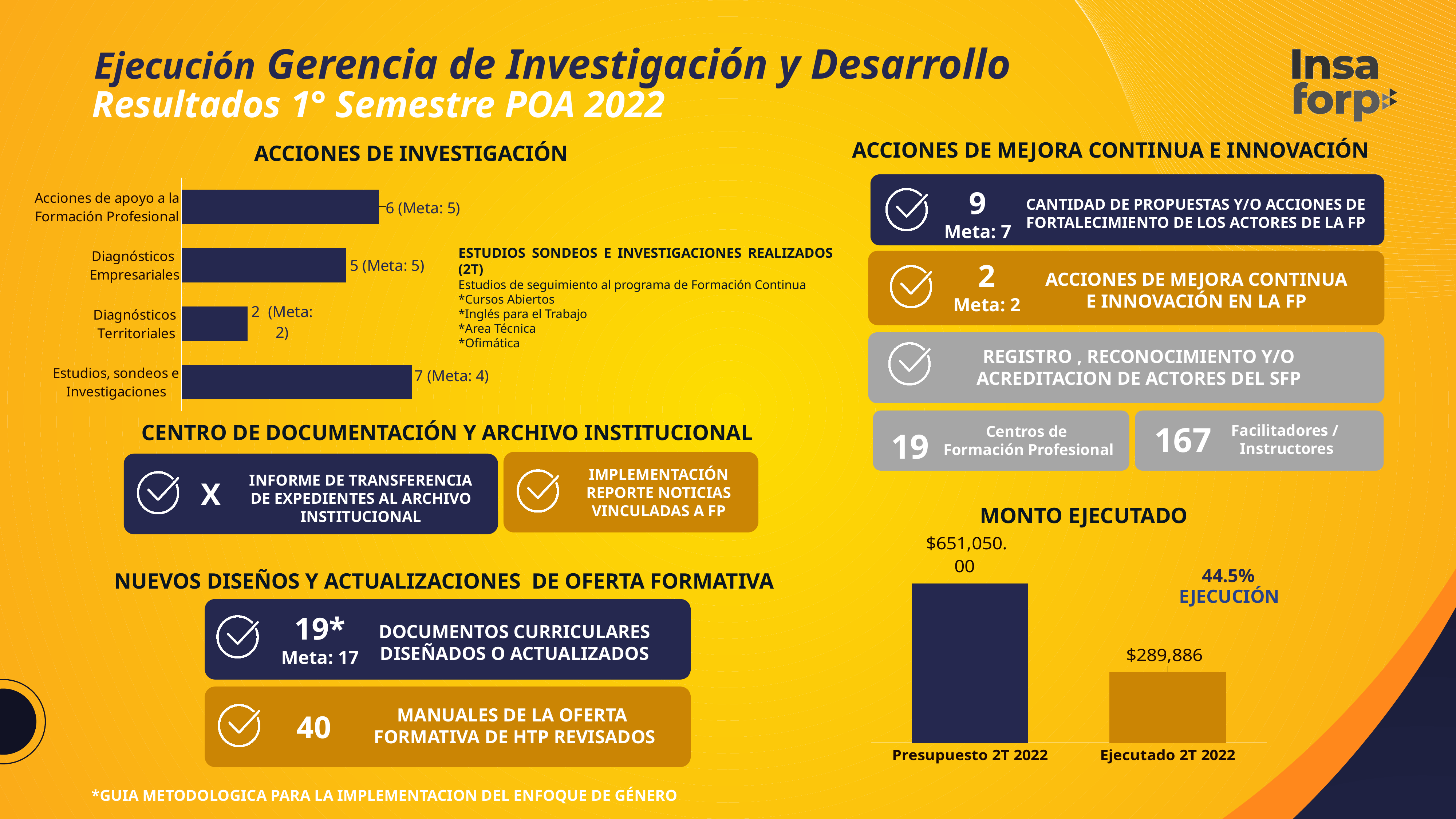
In the 'MONTO EJECUTADO' chart, what is the value for Ejecutado 2T 2022? $289,886 How many categories does the 'ACCIONES DE INVESTIGACIÓN' chart show? 4 In the 'MONTO EJECUTADO' chart, which bar is higher: Presupuesto 2T 2022 or Ejecutado 2T 2022? Presupuesto 2T 2022 What kind of chart is 'ACCIONES DE INVESTIGACIÓN'? Bar chart In the 'MONTO EJECUTADO' chart, what is the value for Presupuesto 2T 2022? $651,050.00 In the 'ACCIONES DE INVESTIGACIÓN' chart, which category has the lowest value? Diagnósticos Territoriales In the 'ACCIONES DE INVESTIGACIÓN' chart, what is the difference between the values for Estudios, sondeos e Investigaciones and Diagnósticos Territoriales? 5 In the 'ACCIONES DE INVESTIGACIÓN' chart, which is larger: Acciones de apoyo a la Formación Profesional or Diagnósticos Empresariales? Acciones de apoyo a la Formación Profesional In the 'ACCIONES DE INVESTIGACIÓN' chart, what is the value for Estudios, sondeos e Investigaciones? 7 (Meta: 4) In the 'ACCIONES DE INVESTIGACIÓN' chart, which category has the highest value? Estudios, sondeos e Investigaciones In the 'ACCIONES DE INVESTIGACIÓN' chart, what is the value for Acciones de apoyo a la Formación Profesional? 6 (Meta: 5) In the 'ACCIONES DE INVESTIGACIÓN' chart, what is the value for Diagnósticos Empresariales? 5 (Meta: 5)